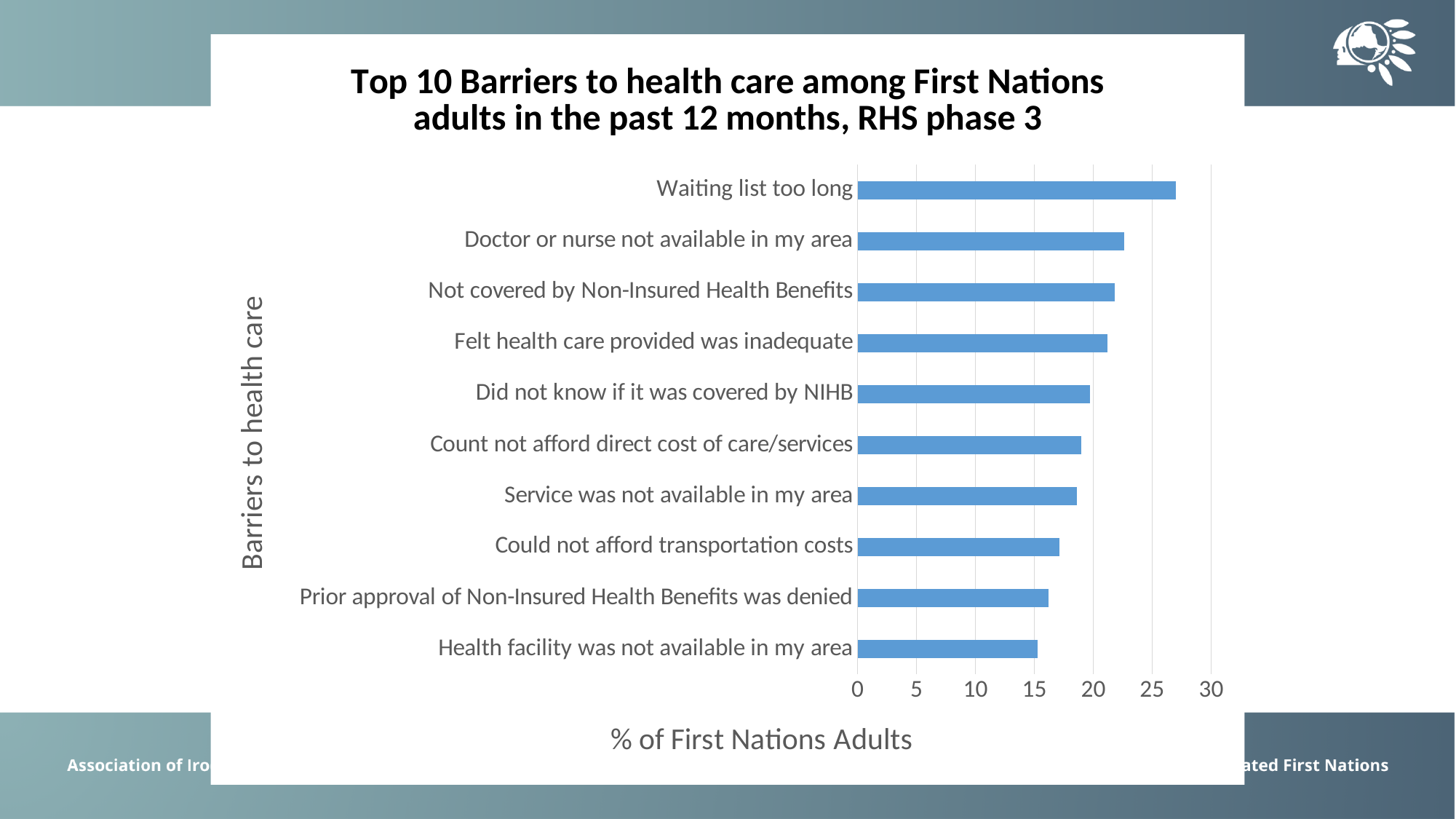
How many barriers to health care are plotted in the chart? 10 Is the value for "Waiting list too long" greater or less than 25? greater What is the label of the horizontal axis of the chart? % of First Nations Adults Which barrier has the highest percentage of First Nations adults? Waiting list too long Is the value for "Could not afford transportation costs" greater or less than 15? greater Which is larger: the value for "Prior approval of Non-Insured Health Benefits was denied" or the value for "Felt health care provided was inadequate"? Felt health care provided was inadequate Is the value for "Doctor or nurse not available in my area" greater or less than 20? greater What kind of chart is shown on the slide? Bar chart Which barrier has the lowest percentage of First Nations adults? Health facility was not available in my area Which is larger: the value for "Waiting list too long" or the value for "Did not know if it was covered by NIHB"? Waiting list too long What is the title of the chart? Top 10 Barriers to health care among First Nations adults in the past 12 months, RHS phase 3